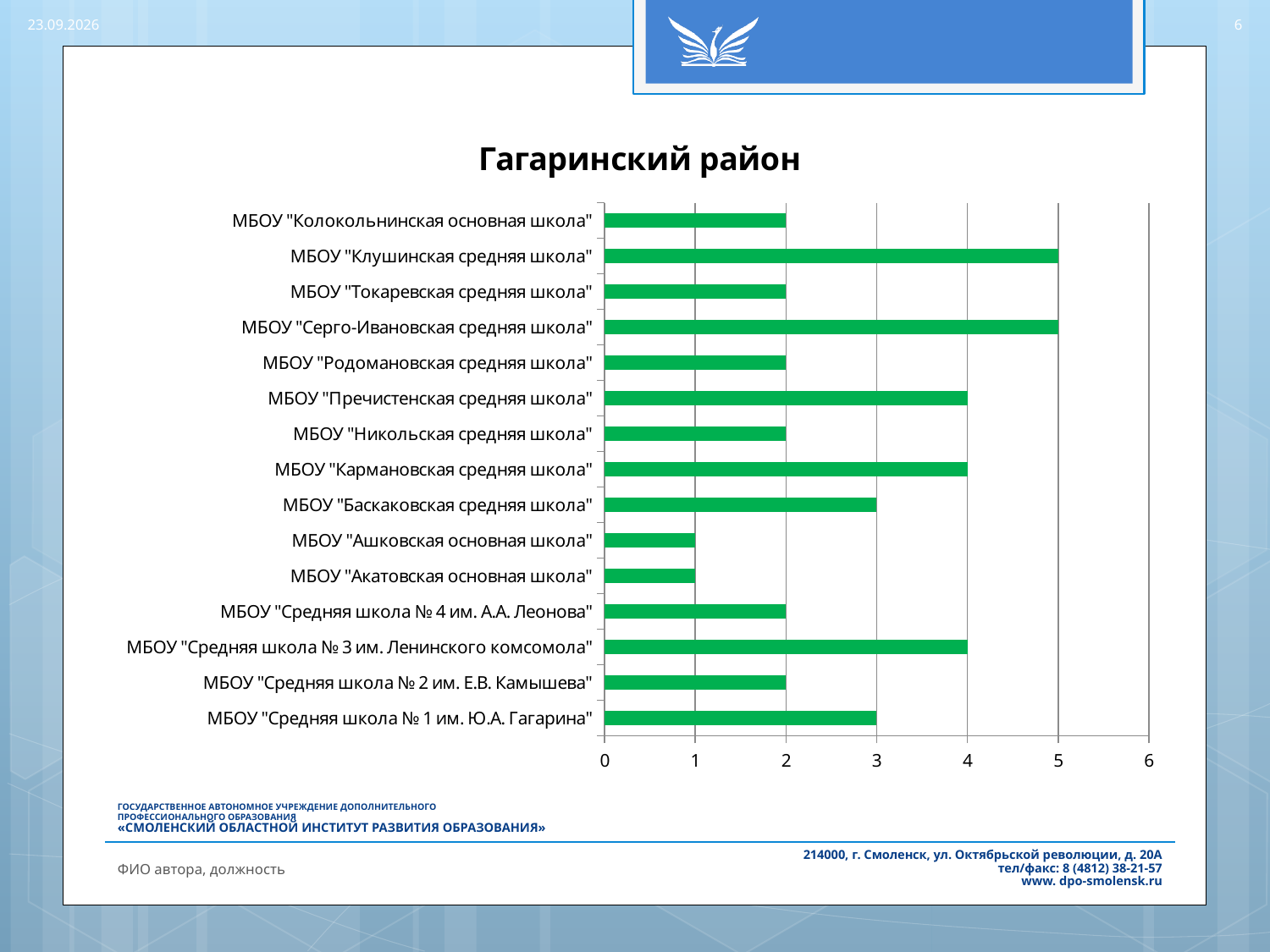
What is the value for МБОУ "Средняя школа № 1 им. Ю.А. Гагарина"? 3 How many schools are listed on the chart? 15 What is the value for МБОУ "Баскаковская средняя школа"? 3 Which has a larger value: МБОУ "Пречистенская средняя школа" or МБОУ "Токаревская средняя школа"? МБОУ "Пречистенская средняя школа" Is the value for МБОУ "Кармановская средняя школа" greater or less than 3? greater What kind of chart is shown on the slide? bar chart What is the value for МБОУ "Ашковская основная школа"? 1 What is the value for МБОУ "Средняя школа № 3 им. Ленинского комсомола"? 4 What is the value for МБОУ "Клушинская средняя школа"? 5 What is the difference between the values for МБОУ "Серго-Ивановская средняя школа" and МБОУ "Родомановская средняя школа"? 3 What is the highest value shown on the chart? 5 What is the title of the chart? Гагаринский район